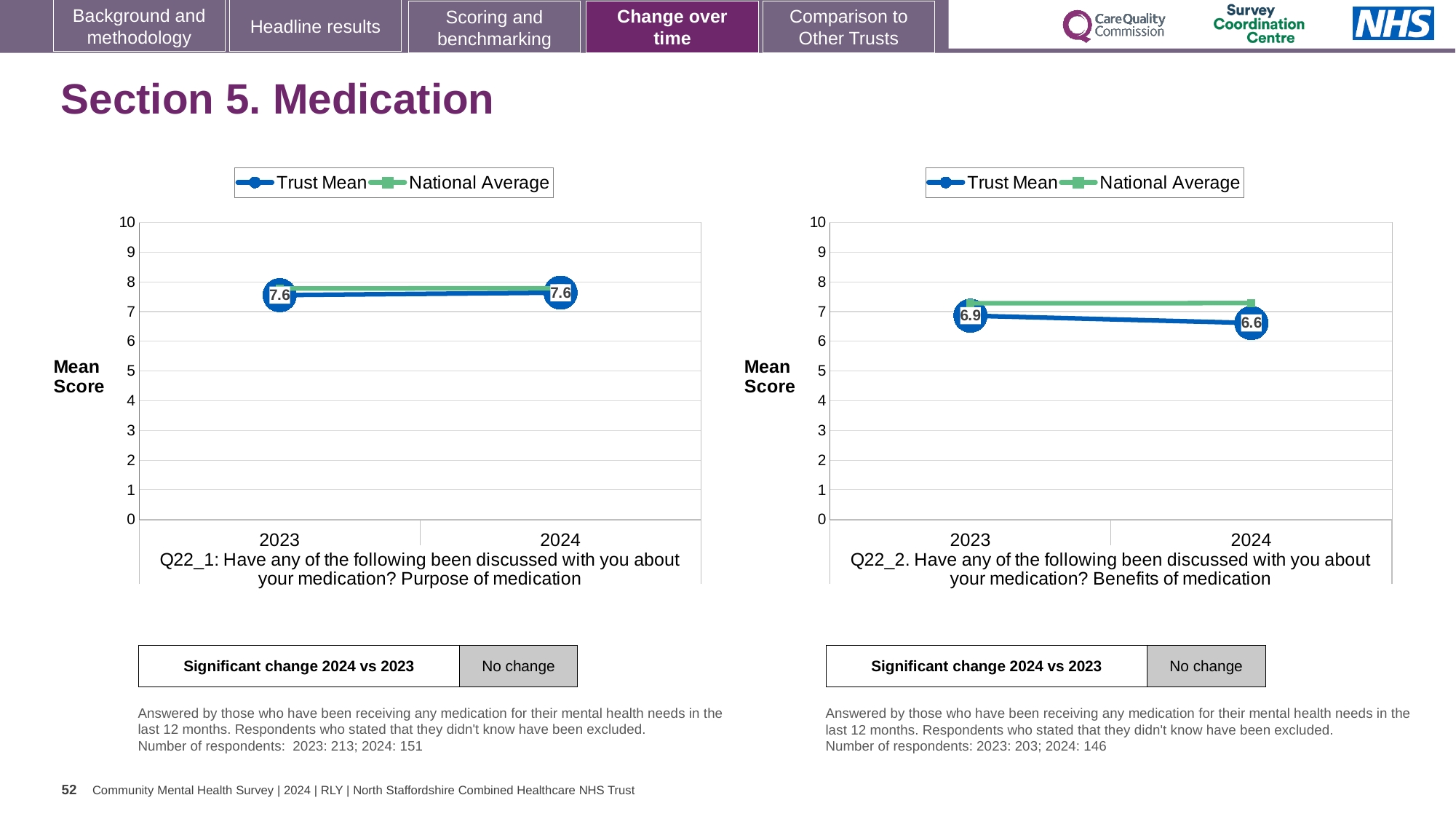
On the right chart (Q22_2: Benefits of medication), what is the Trust Mean score for 2023? 6.9 How many series does the legend of the left chart (Q22_1: Purpose of medication) list? 2 How many years are plotted on the x axis of the left chart (Q22_1: Purpose of medication)? 2 On the right chart (Q22_2: Benefits of medication), is the National Average for 2024 greater or less than 7? greater On the right chart (Q22_2: Benefits of medication), does the Trust Mean rise or fall from 2023 to 2024? fall On the left chart (Q22_1: Purpose of medication), is the National Average for 2023 greater or less than 7? greater On the left chart (Q22_1: Purpose of medication), what is the Trust Mean score for 2024? 7.6 On the right chart (Q22_2: Benefits of medication), what is the Trust Mean score for 2024? 6.6 On the right chart (Q22_2: Benefits of medication), what is the difference between the Trust Mean scores for 2023 and 2024? 0.3 On the left chart (Q22_1: Purpose of medication), what is the Trust Mean score for 2023? 7.6 What kind of chart is the right chart (Q22_2: Benefits of medication)? line chart On the right chart (Q22_2: Benefits of medication), which year has the higher Trust Mean score, 2023 or 2024? 2023